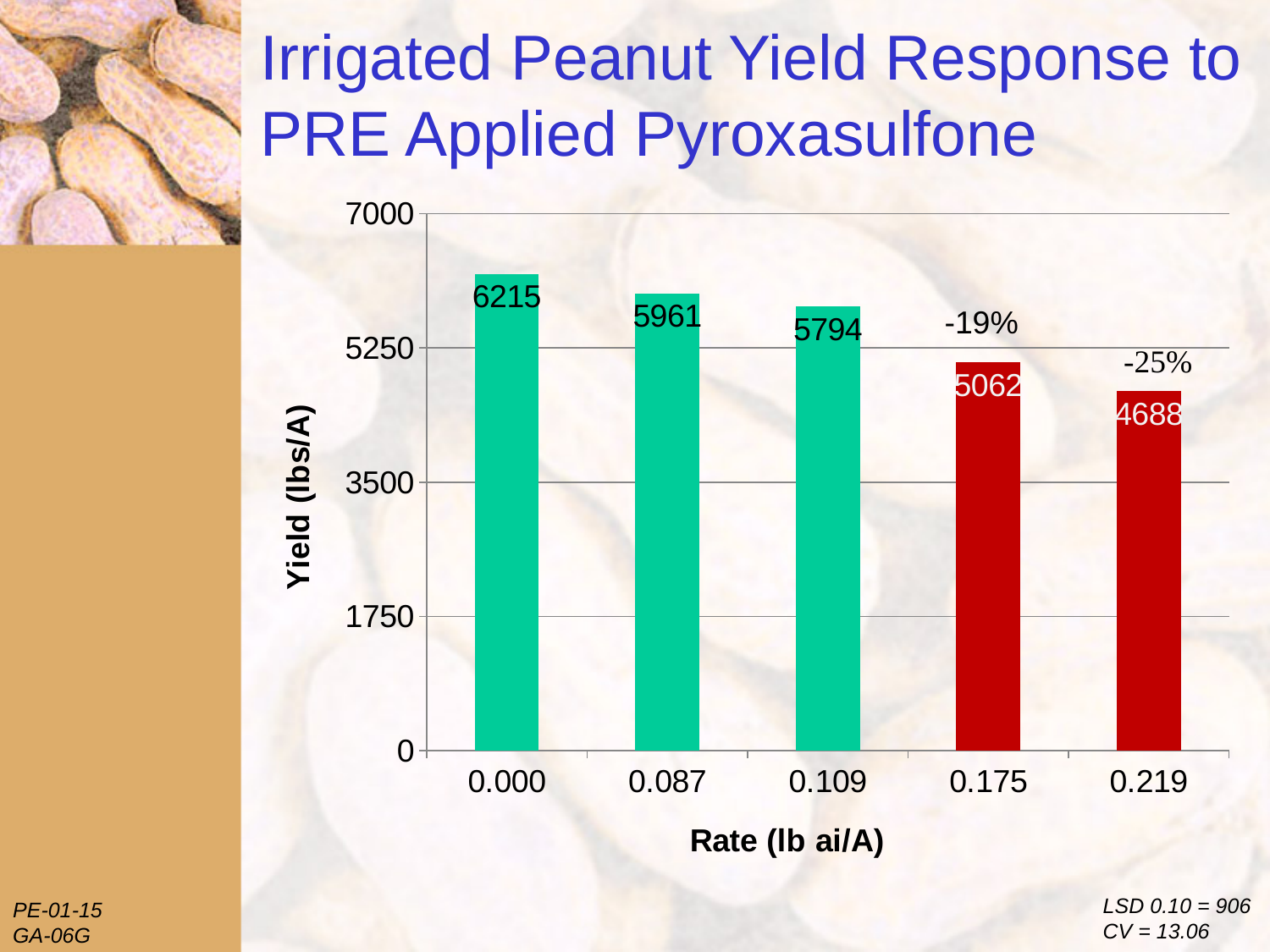
What percentage change is labelled above the 0.175 rate bar? -19% What is the difference in yield between the 0.087 and 0.109 rates? 167 Does yield rise or fall as the rate increases along the x axis? fall How many rates are shown on the x axis? 5 What is the yield at a rate of 0.000 lb ai/A? 6215 What is the yield at a rate of 0.175 lb ai/A? 5062 Which rate has the lowest yield? 0.219 What is the difference in yield between the 0.000 and 0.219 rates? 1527 Which rate has the highest yield? 0.000 Which has a higher yield, the 0.109 rate or the 0.175 rate? 0.109 What kind of chart is shown? bar chart What is the yield at a rate of 0.219 lb ai/A? 4688